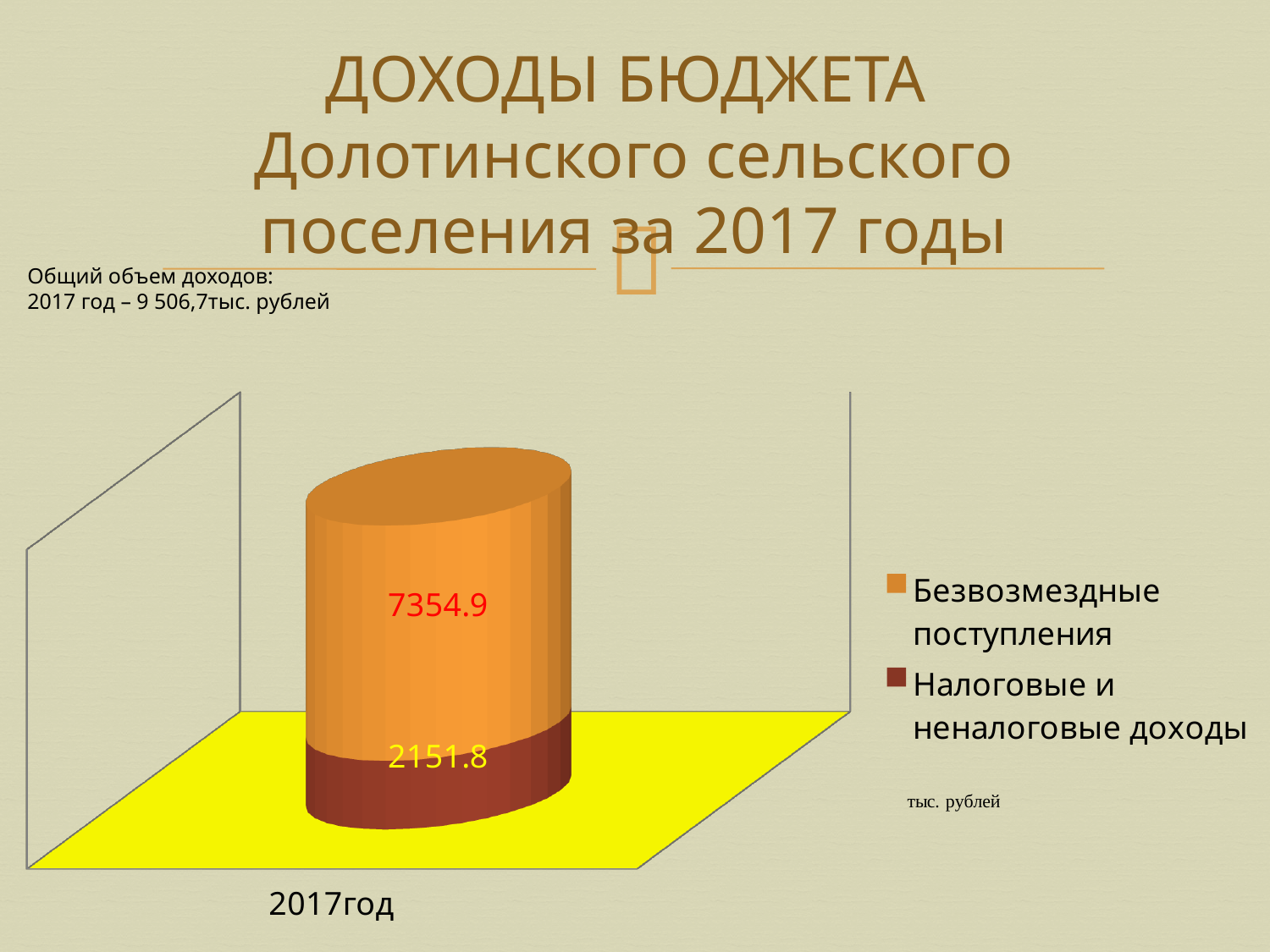
What unit is indicated next to the legend of the chart? тыс. рублей What is the category label shown under the bar? 2017год Which series has the largest value in the chart? Безвозмездные поступления What is the difference between Безвозмездные поступления and Налоговые и неналоговые доходы in 2017год? 5203.1 How many series does the legend list? 2 What is the total of the stacked bar for 2017год? 9506.7 What is the value for Безвозмездные поступления in 2017год? 7354.9 What type of chart is shown on the slide? Stacked bar chart How many categories are shown on the x axis of the chart? 1 What is the value for Налоговые и неналоговые доходы in 2017год? 2151.8 Which series has the smallest value in the chart? Налоговые и неналоговые доходы Which series has the larger value in 2017год: Безвозмездные поступления or Налоговые и неналоговые доходы? Безвозмездные поступления